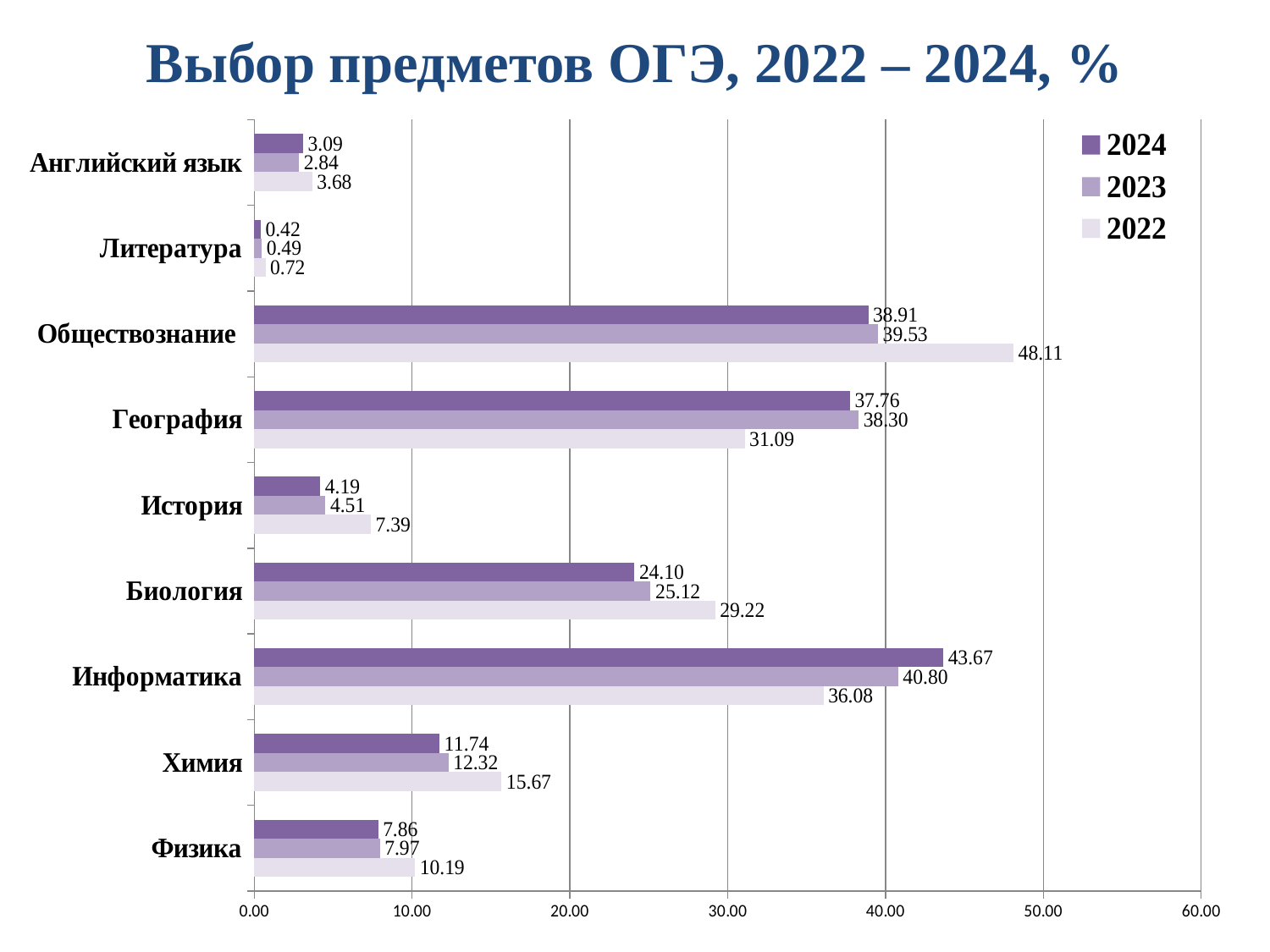
How many series does the legend list? 3 What kind of chart is shown on the slide? Bar chart How many subjects are shown on the chart? 9 What is the value for Информатика in 2024? 43.67 What is the value for Химия in 2023? 12.32 What is the value for Обществознание in 2022? 48.11 What is the difference between the 2022 and 2024 values for Обществознание? 9.20 What is the title of the chart? Выбор предметов ОГЭ, 2022 – 2024, % For География, which year has the larger value, 2023 or 2022? 2023 Which subject has the lowest value in the 2022 series? Литература Which subject has the highest value in the 2024 series? Информатика What is the difference between the 2024 and 2022 values for Информатика? 7.59